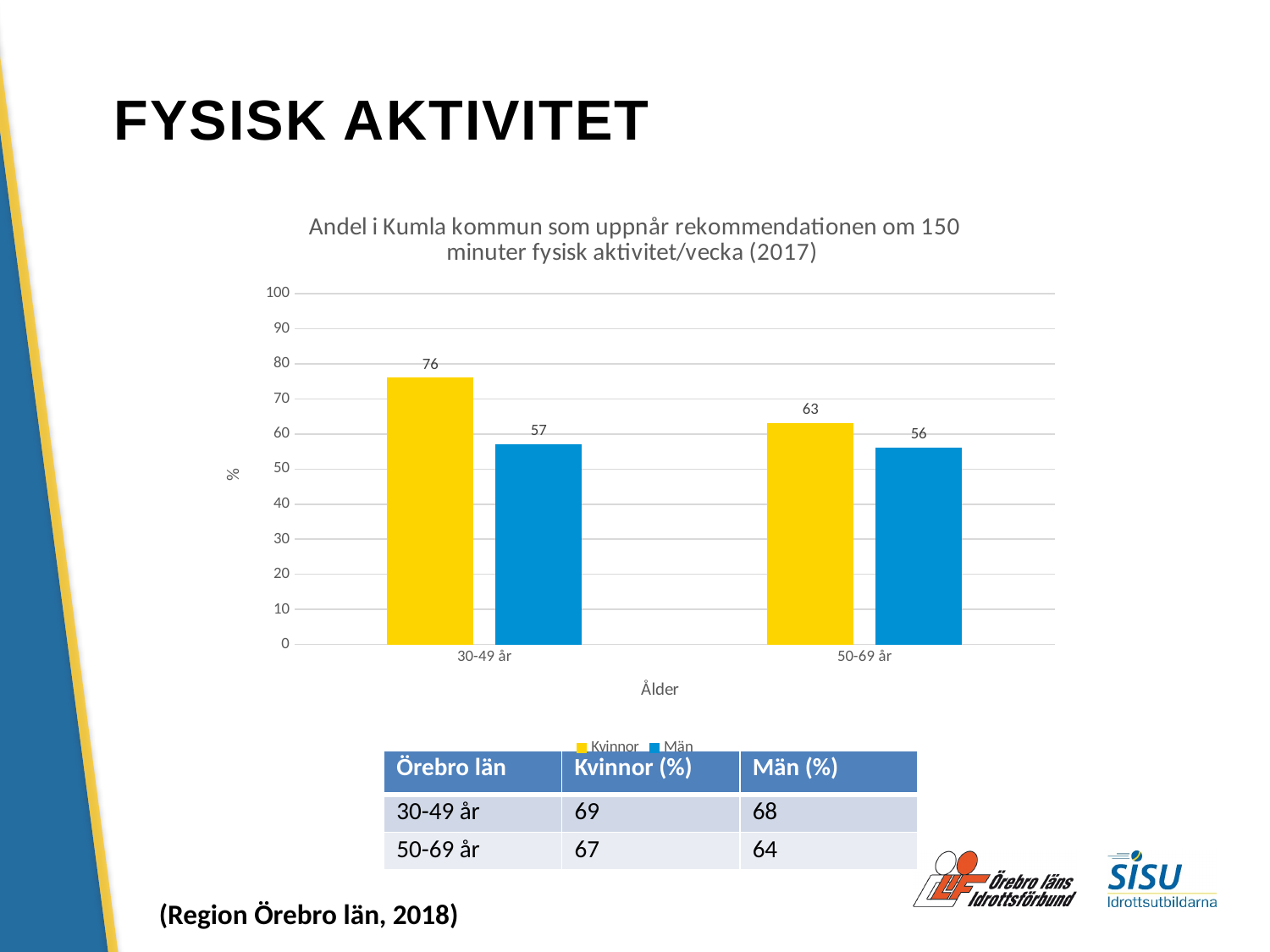
What kind of chart is shown on the slide? Bar chart Which is larger in the 50-69 år age group, Kvinnor or Män? Kvinnor What is the value for Kvinnor in the 30-49 år age group? 76 Which age group has the highest value for Kvinnor? 30-49 år What colour represents Kvinnor in the chart? Yellow How many age groups are shown on the x axis? 2 What is the difference between Kvinnor and Män in the 50-69 år age group? 7 How many series does the legend list? 2 What is the value for Kvinnor in the 50-69 år age group? 63 Which age group has the lowest value for Män? 50-69 år What is the difference between Kvinnor and Män in the 30-49 år age group? 19 What is the value for Män in the 50-69 år age group? 56